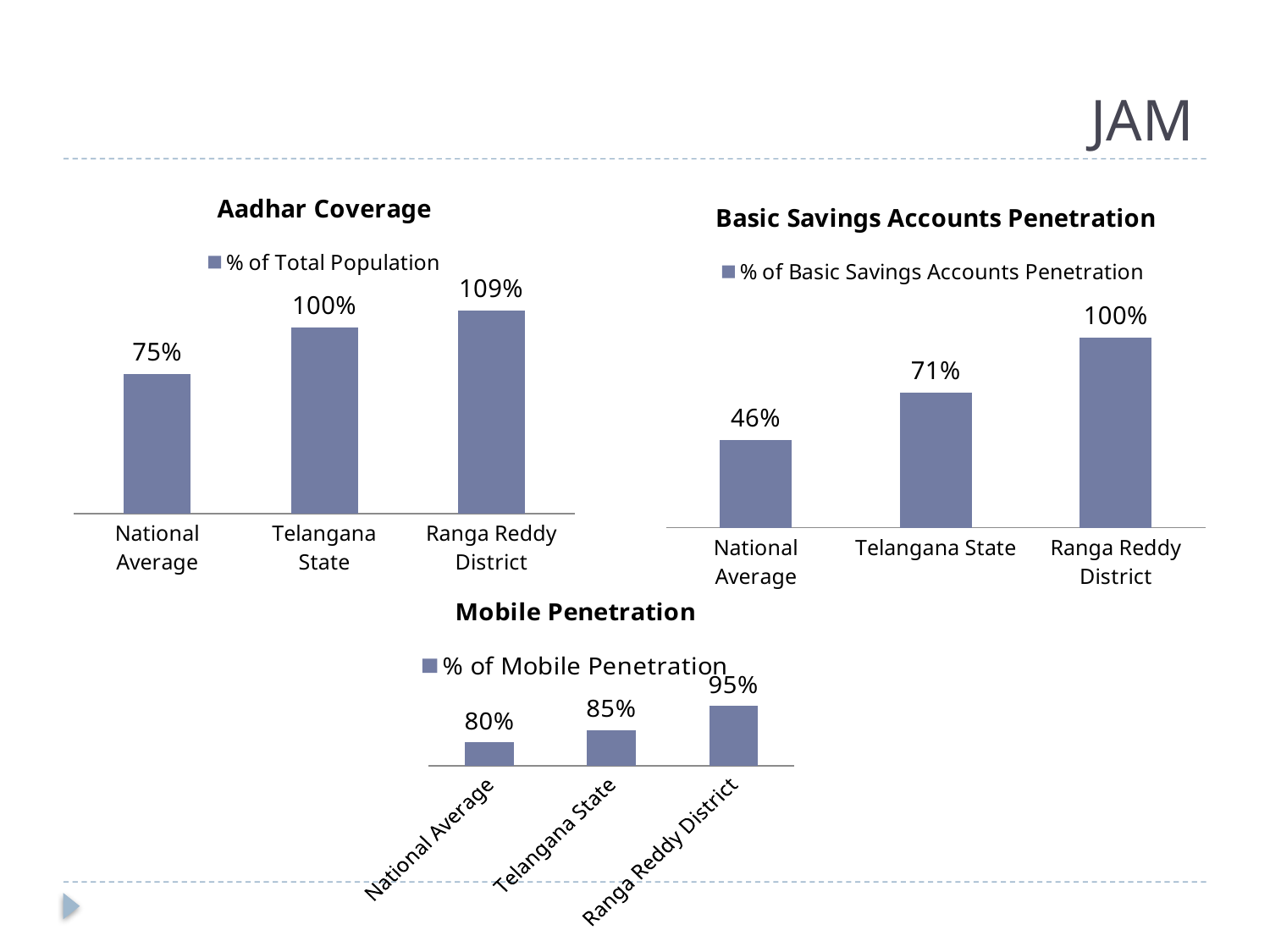
In the Basic Savings Accounts Penetration chart, what is the difference between Ranga Reddy District and Telangana State? 29% In the Mobile Penetration chart, do the values rise or fall from National Average to Ranga Reddy District? rise In the Aadhar Coverage chart, what is the value for Telangana State? 100% In the Basic Savings Accounts Penetration chart, what is the value for National Average? 46% What is the legend entry in the Mobile Penetration chart? % of Mobile Penetration In the Aadhar Coverage chart, which category has the highest value? Ranga Reddy District What kind of chart is the Basic Savings Accounts Penetration chart? bar chart In the Aadhar Coverage chart, what is the difference between Ranga Reddy District and National Average? 34% In the Mobile Penetration chart, which is larger, National Average or Ranga Reddy District? Ranga Reddy District How many categories does the Aadhar Coverage chart show? 3 In the Basic Savings Accounts Penetration chart, which category has the lowest value? National Average In the Mobile Penetration chart, what is the value for Telangana State? 85%